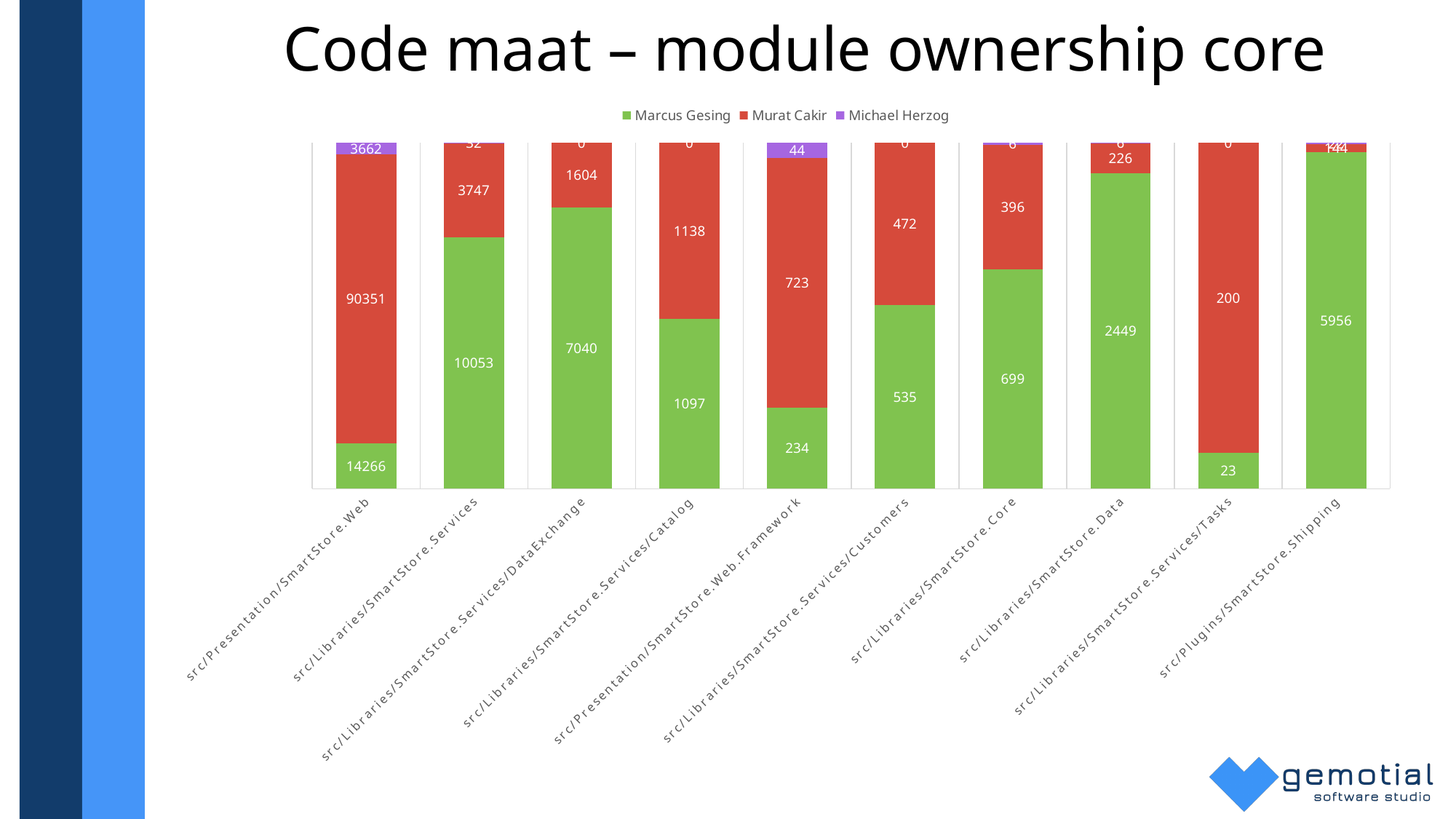
What is the value for Michael Herzog in src/Presentation/SmartStore.Web.Framework? 44 Which module has the highest value for Marcus Gesing? src/Presentation/SmartStore.Web How many series does the legend list? 3 What kind of chart is shown on the slide? bar chart What is the total of the stacked bar for src/Libraries/SmartStore.Services/Tasks? 223 What is the value for Michael Herzog in src/Presentation/SmartStore.Web? 3662 How many module categories are shown on the x axis? 10 What is the difference between Murat Cakir's and Marcus Gesing's values in src/Presentation/SmartStore.Web? 76085 In src/Libraries/SmartStore.Services/Catalog, who has the larger value, Marcus Gesing or Murat Cakir? Murat Cakir What is the value for Murat Cakir in src/Presentation/SmartStore.Web? 90351 What is the value for Marcus Gesing in src/Presentation/SmartStore.Web? 14266 What is the value for Marcus Gesing in src/Libraries/SmartStore.Services/DataExchange? 7040